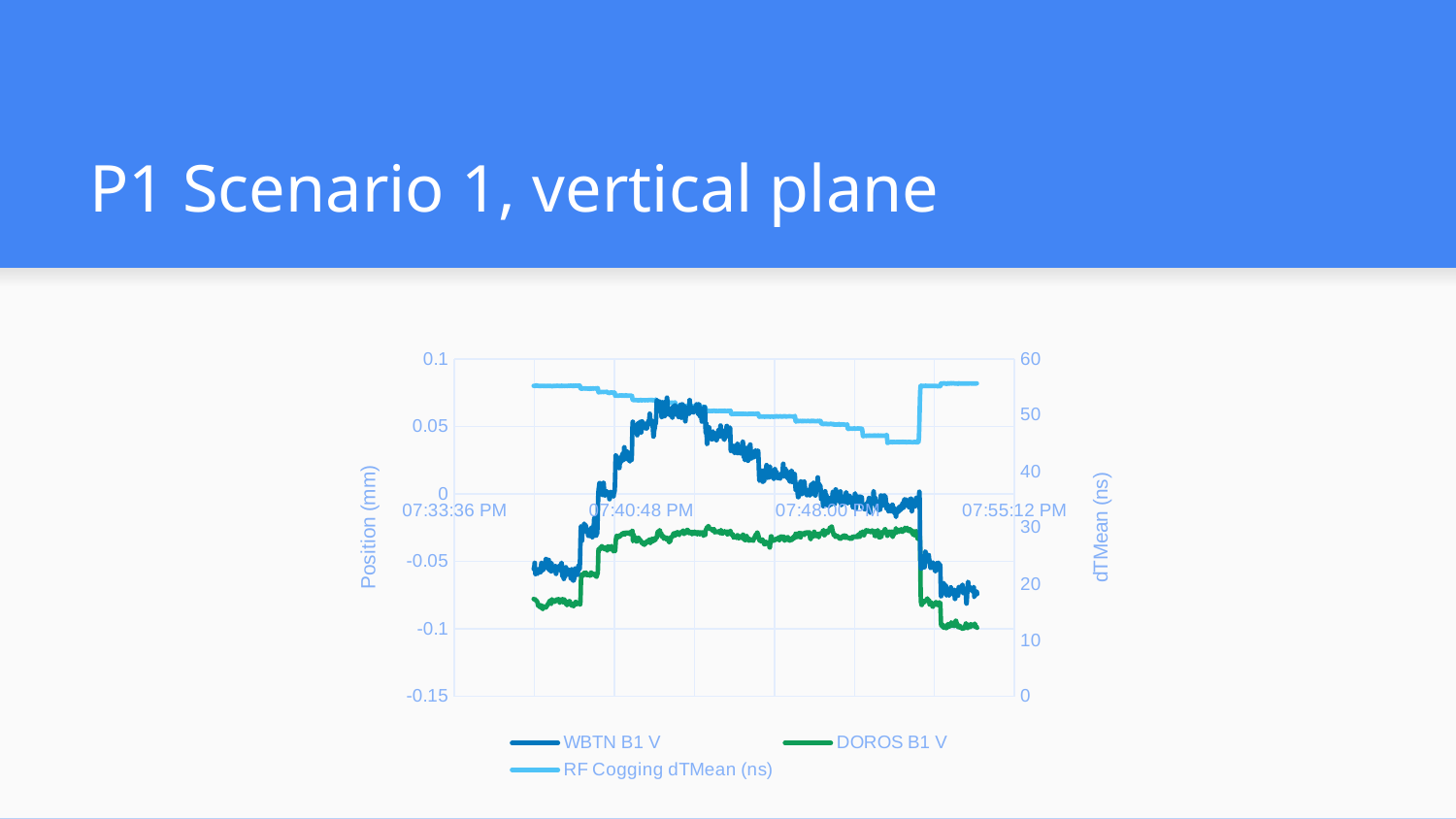
What kind of chart is shown on the slide? line chart What is the title of the left vertical axis? Position (mm) Which series is plotted against the right-hand dTMean (ns) axis? RF Cogging dTMean (ns) Is the value of DOROS B1 V at the start of the plotted period greater or less than -0.05? less Does the RF Cogging dTMean (ns) series rise or fall between 07:33:36 PM and 07:48:00 PM? fall Is the highest value reached by DOROS B1 V greater or less than 0? less At the end of the plotted period, which series has the higher position value, WBTN B1 V or DOROS B1 V? WBTN B1 V Is the value of RF Cogging dTMean (ns) just before its final jump upward greater or less than 50? less How many time labels are shown on the x axis? 4 How many series does the chart legend list? 3